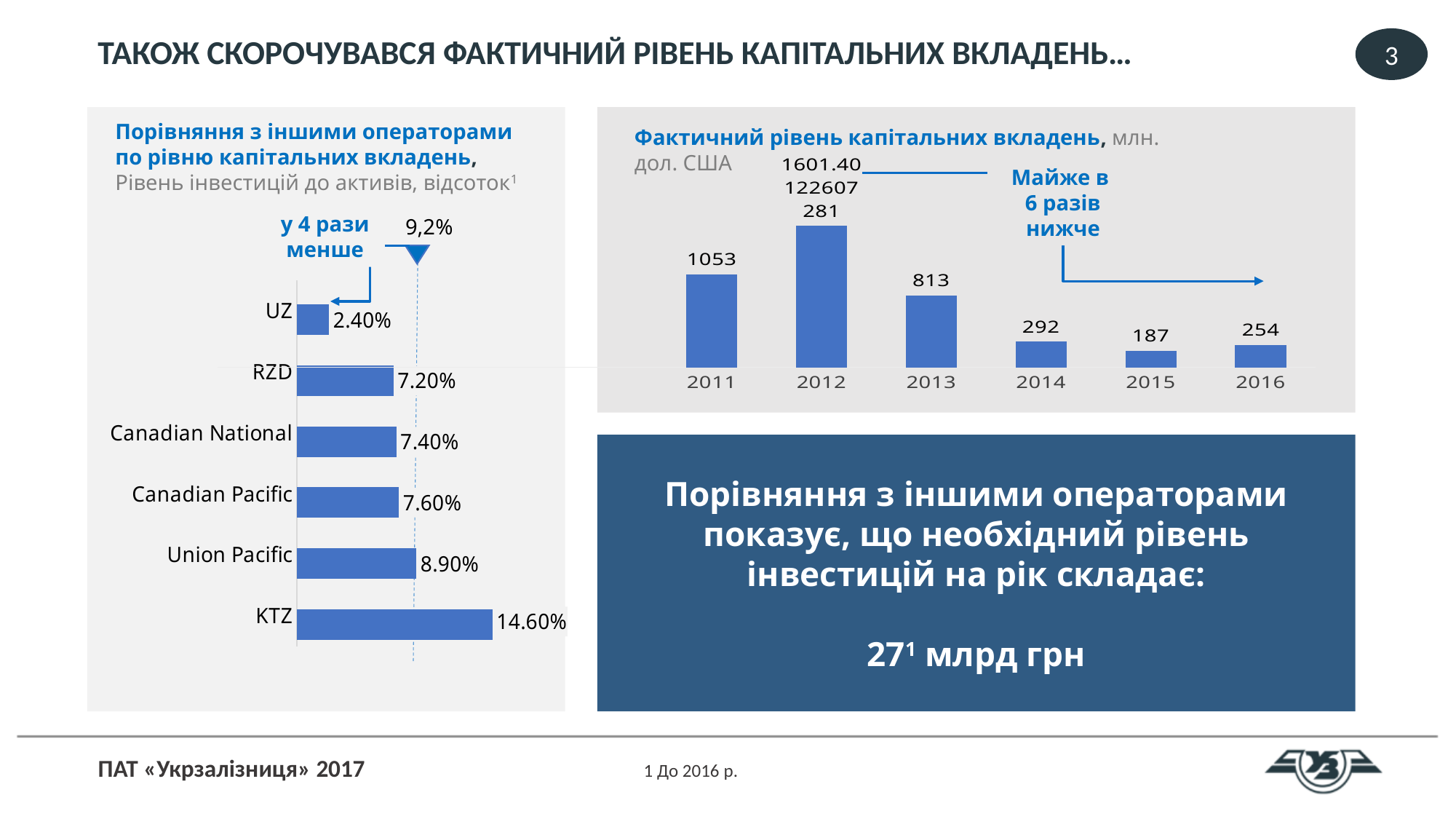
In the right chart of actual level of capital investment, which year has the lowest value? 2015 In the left chart comparing operators by level of capital investment, what is the difference between Union Pacific and UZ? 6.50% What type of chart is the left chart comparing operators by level of capital investment? Bar chart In the left chart comparing operators by level of capital investment, which operator has the lowest value? UZ In the left chart comparing operators by level of capital investment, what is the value for KTZ? 14.60% In the right chart of actual level of capital investment, what is the value for 2011? 1053 In the right chart of actual level of capital investment, what is the value for 2015? 187 How many operators are shown in the left chart comparing operators by level of capital investment? 6 In the right chart of actual level of capital investment, what is the difference between 2013 and 2014? 521 In the left chart comparing operators by level of capital investment, which operator has the highest value? KTZ In the left chart comparing operators by level of capital investment, which is larger: Canadian Pacific or RZD? Canadian Pacific In the left chart comparing operators by level of capital investment, what is the value for UZ? 2.40%